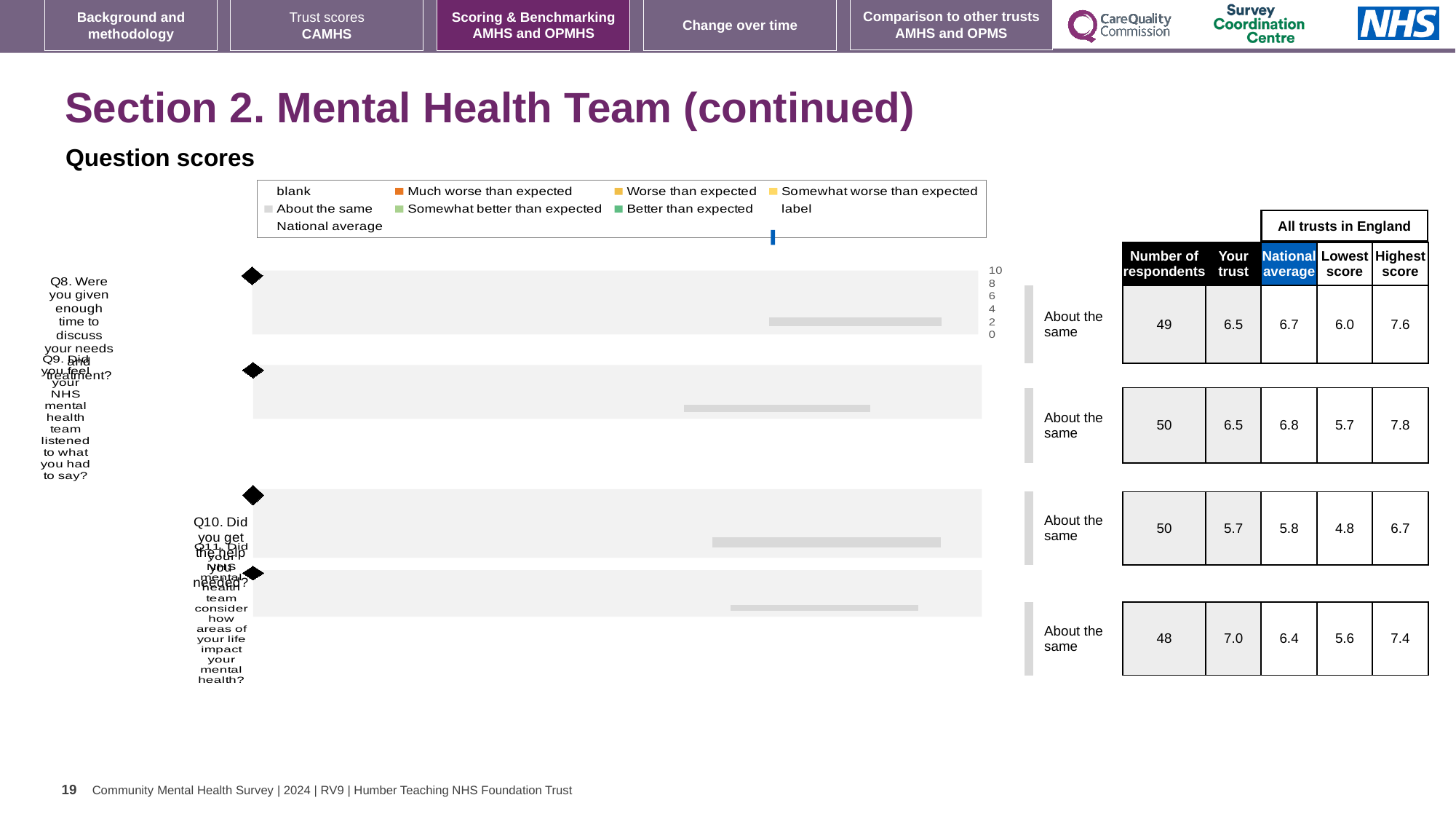
What is the lowest score across all trusts in England for Q9? 5.7 What kind of chart is used to show the question scores on this slide? bar chart What benchmark category is shown for Q9 in the chart? About the same According to the table next to the chart, what is the 'Your trust' score for Q8? 6.5 How many questions (categories) are plotted in the question scores chart? 4 Which question has the highest 'Your trust' score in the table next to the chart? Q11 According to the table next to the chart, what is the national average for Q9? 6.8 For Q8, which is larger: the 'Your trust' score or the national average? National average Which question has the lowest 'Your trust' score in the table next to the chart? Q10 According to the table next to the chart, what is the highest score across all trusts in England for Q10? 6.7 What is the difference between the 'Your trust' score and the national average for Q11? 0.6 According to the table next to the chart, how many respondents answered Q11? 48